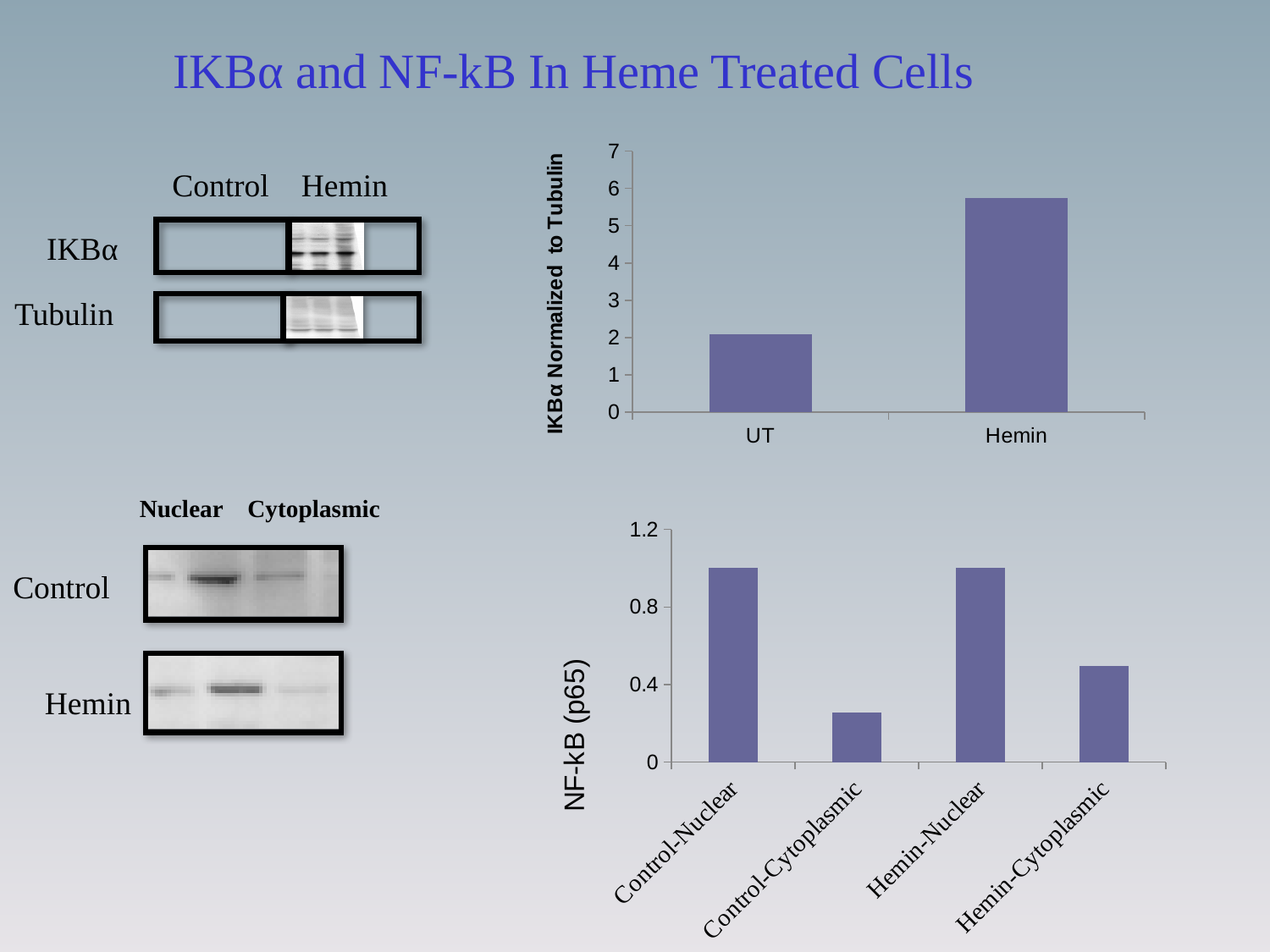
What is the y-axis title of the top-right chart? IKBα Normalized to Tubulin In the bottom-right chart (NF-kB (p65)), is the value for Control-Cytoplasmic greater or less than 0.4? less In the top-right chart (IKBα Normalized to Tubulin), is the value for Hemin greater or less than 5? greater How many categories are shown in the bottom-right chart (NF-kB (p65))? 4 What kind of chart is the top-right chart (IKBα Normalized to Tubulin)? bar chart In the top-right chart (IKBα Normalized to Tubulin), is the value for UT greater or less than 3? less In the bottom-right chart (NF-kB (p65)), which category has the lowest value? Control-Cytoplasmic In the bottom-right chart (NF-kB (p65)), which is larger: Hemin-Cytoplasmic or Control-Cytoplasmic? Hemin-Cytoplasmic In the top-right chart (IKBα Normalized to Tubulin), which category has the highest value? Hemin In the top-right chart (IKBα Normalized to Tubulin), which category has the lowest value? UT How many categories are shown in the top-right chart (IKBα Normalized to Tubulin)? 2